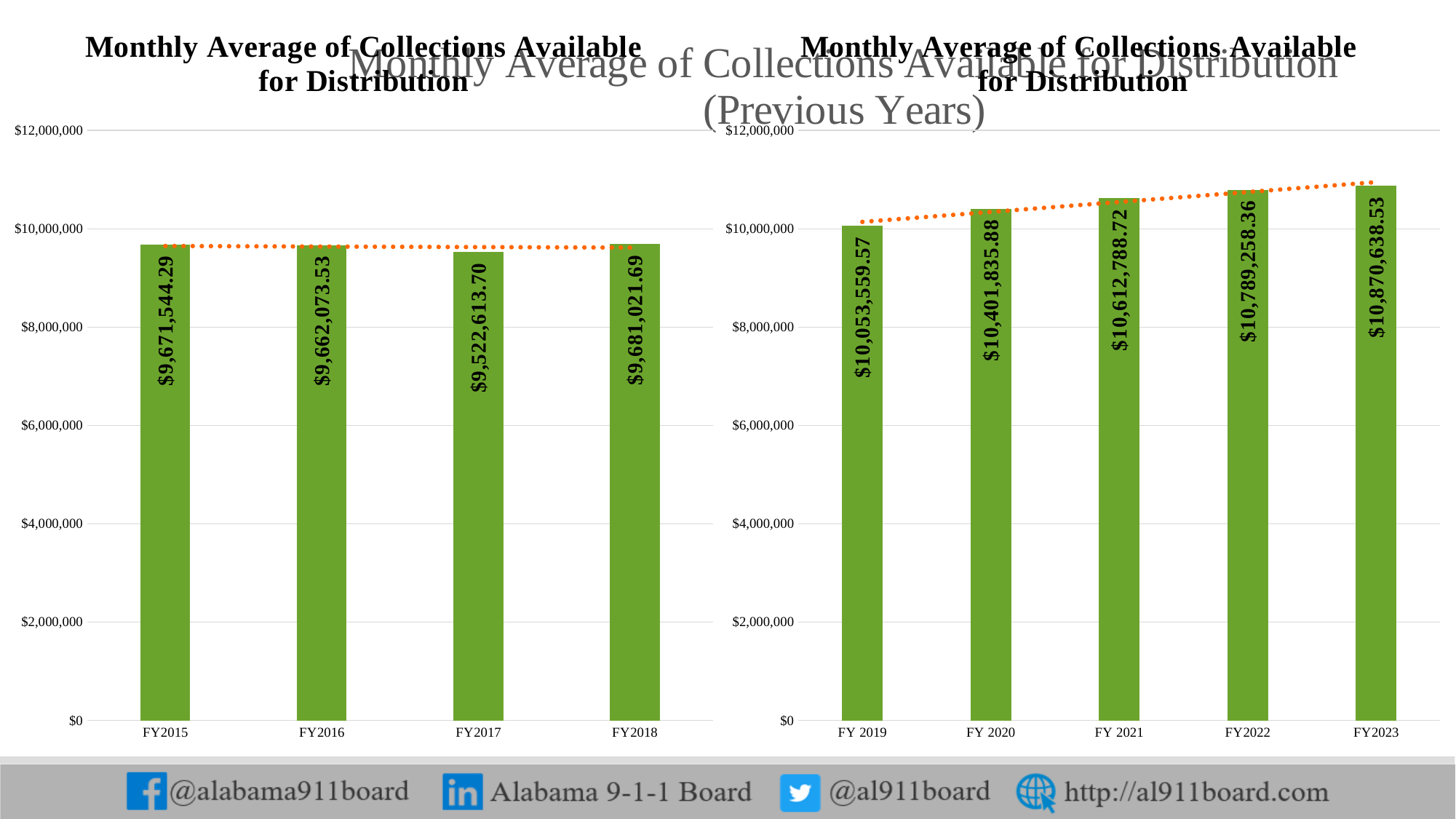
On the right chart, what is the difference between the FY2023 and FY 2019 values? $817,078.96 On the right chart, which fiscal year has the lowest value? FY 2019 On the left chart, what is the difference between the FY2018 and FY2017 values? $158,407.99 On the right chart, what is the value for FY 2021? $10,612,788.72 How many fiscal years are shown on the right chart? 5 On the left chart, what is the value for FY2017? $9,522,613.70 What kind of chart is the left chart? Bar chart On the right chart, what is the value for FY2023? $10,870,638.53 On the right chart, is the value for FY 2020 larger than the value for FY 2019? Yes On the right chart, do the values rise or fall from FY 2019 to FY2023? Rise On the left chart, which fiscal year has the lowest value? FY2017 On the right chart, which fiscal year has the highest value? FY2023